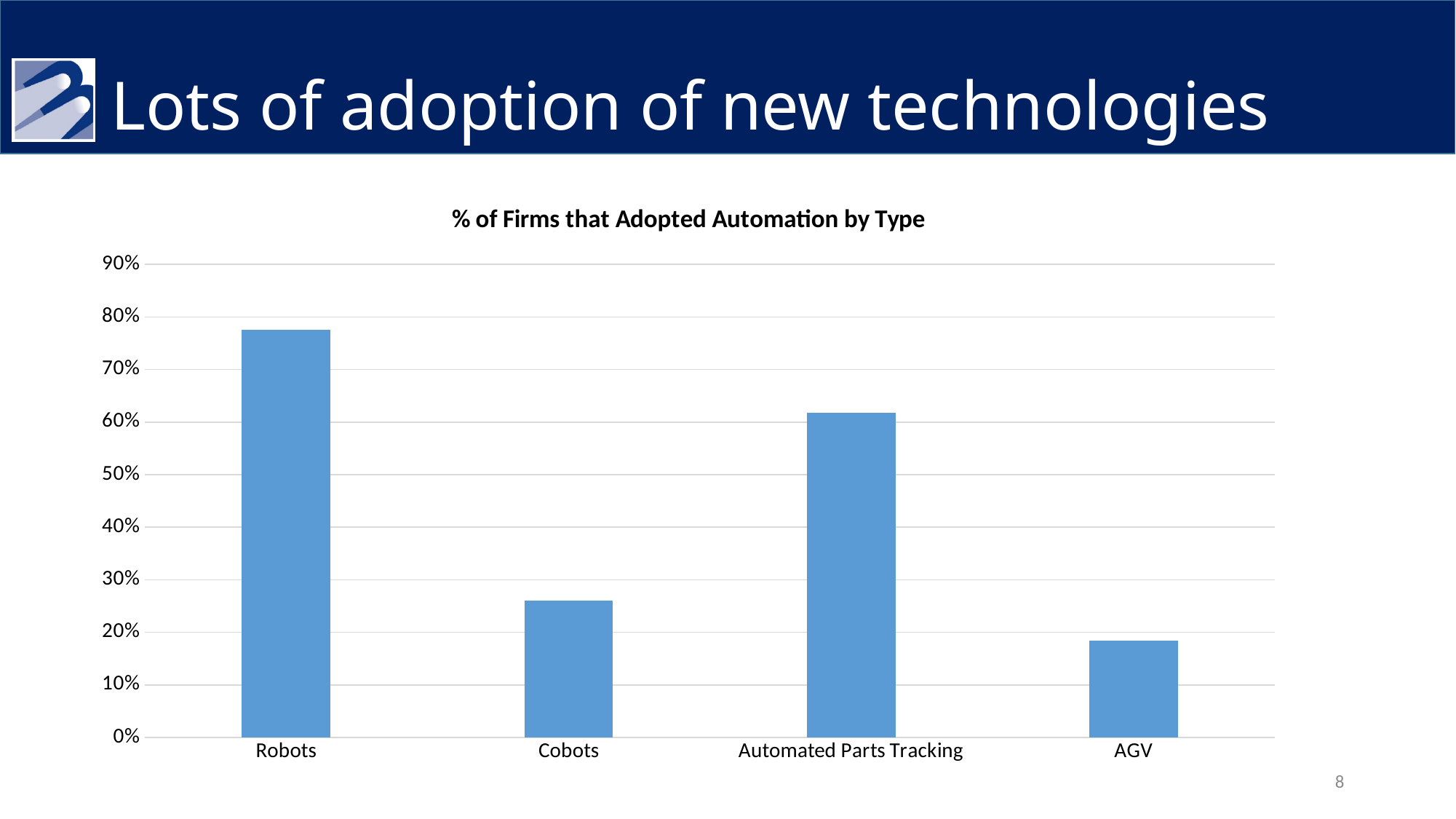
Which automation type has the highest adoption percentage? Robots What is the highest value shown on the y axis of the chart? 90% Is the value for AGV greater or less than 30%? less What is the title of the chart? % of Firms that Adopted Automation by Type Which has a higher adoption percentage, Cobots or Automated Parts Tracking? Automated Parts Tracking Which has a higher adoption percentage, Cobots or AGV? Cobots Is the value for Robots greater or less than 70%? greater Is the value for Cobots greater or less than 30%? less How many automation types are shown on the x axis of the chart? 4 Which automation type has the lowest adoption percentage? AGV What kind of chart is shown on the slide? bar chart